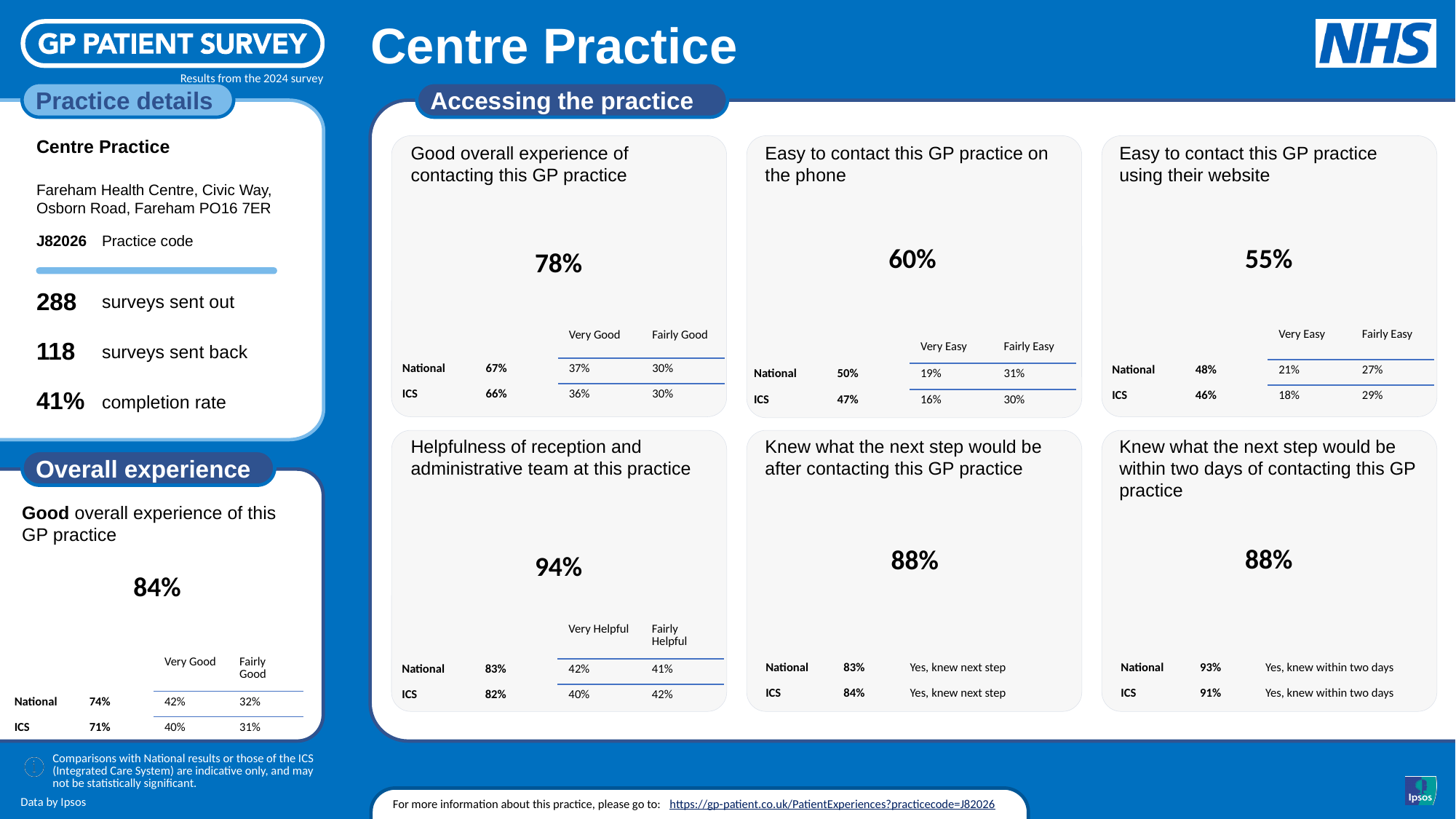
In the 'Good overall experience of this GP practice' panel, what is the total of the ICS 'Very Good' and 'Fairly Good' values? 71% Among the six panels under 'Accessing the practice', which has the highest headline value? Helpfulness of reception and administrative team at this practice In the 'Good overall experience of contacting this GP practice' panel, what is the practice's headline value? 78% In the 'Good overall experience of this GP practice' panel under Overall experience, what is the practice's headline value? 84% In the 'Good overall experience of contacting this GP practice' panel, what is the difference between the practice's headline value and the National value? 11% In the 'Helpfulness of reception and administrative team at this practice' panel, what is the National 'Very Helpful' value? 42% Among the six panels under 'Accessing the practice', which has the lowest headline value? Easy to contact this GP practice using their website In the 'Easy to contact this GP practice on the phone' panel, what is the National value? 50% How many panels are shown under the 'Accessing the practice' heading? 6 In the 'Easy to contact this GP practice using their website' panel, what is the ICS value? 46% In the 'Knew what the next step would be within two days of contacting this GP practice' panel, what is the National value? 93% In the 'Easy to contact this GP practice on the phone' panel, which is larger, the National value or the ICS value? National